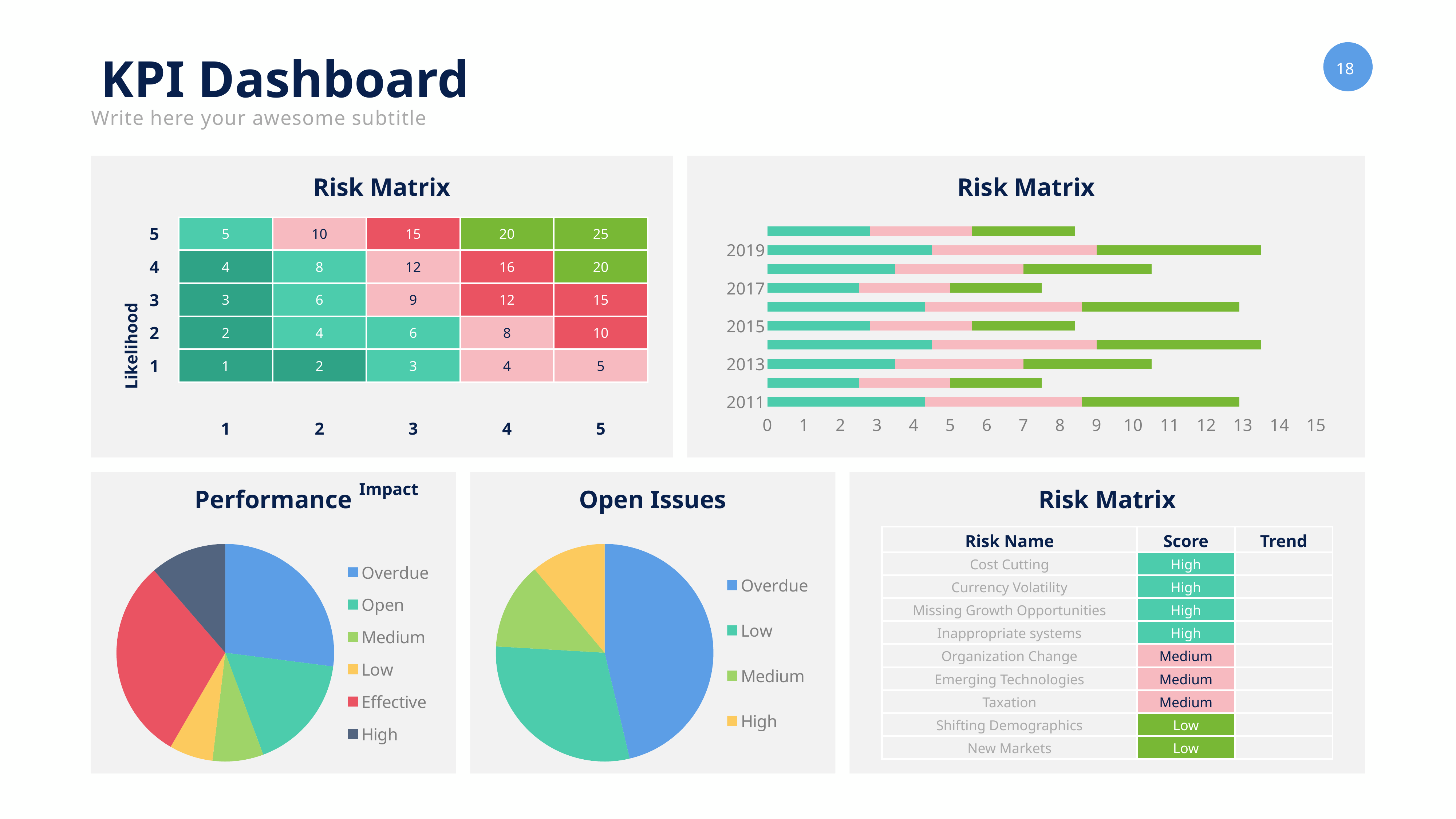
In the top-right 'Risk Matrix' bar chart, is the total length of the 2011 bar greater or less than 12? greater What kind of chart is the top-right 'Risk Matrix' chart? stacked bar chart How many entries does the legend of the 'Open Issues' pie chart list? 4 In the 'Open Issues' pie chart, which category has the largest slice? Overdue In the top-right 'Risk Matrix' bar chart, how many bars are plotted? 10 In the top-right 'Risk Matrix' bar chart, is the total length of the 2017 bar greater or less than 10? less In the top-right 'Risk Matrix' bar chart, is the total length of the 2015 bar greater or less than 10? less How many entries does the legend of the 'Performance' pie chart list? 6 In the 'Performance' pie chart, which slice is larger, Open or Medium? Open What kind of chart is the 'Performance' chart? pie chart In the 'Performance' pie chart, which category has the smallest slice? Low